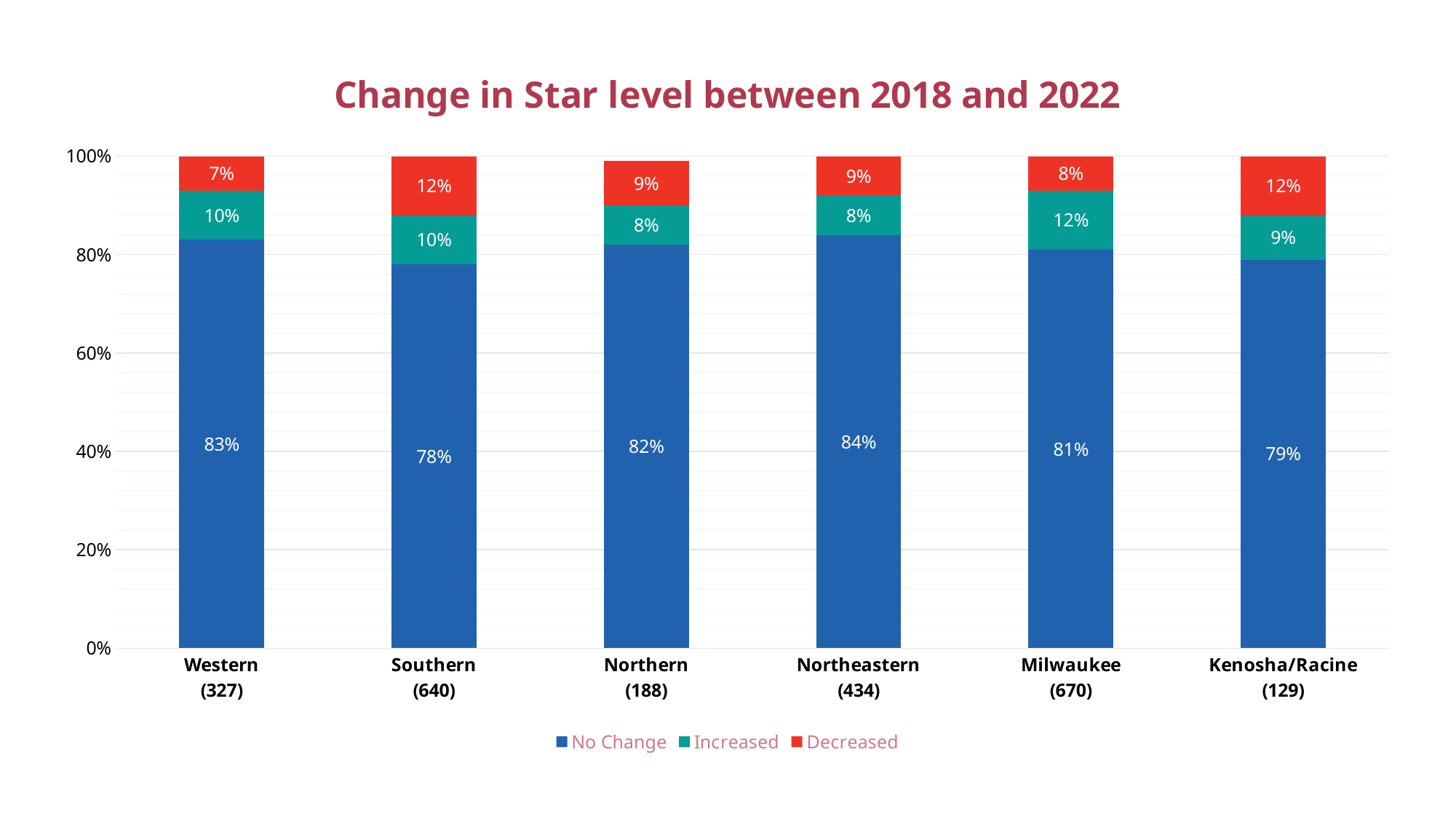
What percentage of the Western region had no change in Star level? 83% What percentage of the Kenosha/Racine region had no change in Star level? 79% Which is larger: the Increased percentage for Milwaukee or for Northern? Milwaukee Which region has the lowest percentage with no change in Star level? Southern Which region has the lowest percentage that decreased in Star level? Western How many regions are shown on the x axis? 6 What kind of chart is shown on the slide? Stacked bar chart What percentage of the Southern region decreased in Star level? 12% Which region has the highest percentage with no change in Star level? Northeastern What percentage of the Milwaukee region increased in Star level? 12% How many series does the legend list? 3 What is the difference between the No Change percentages for Northeastern and Southern? 6%